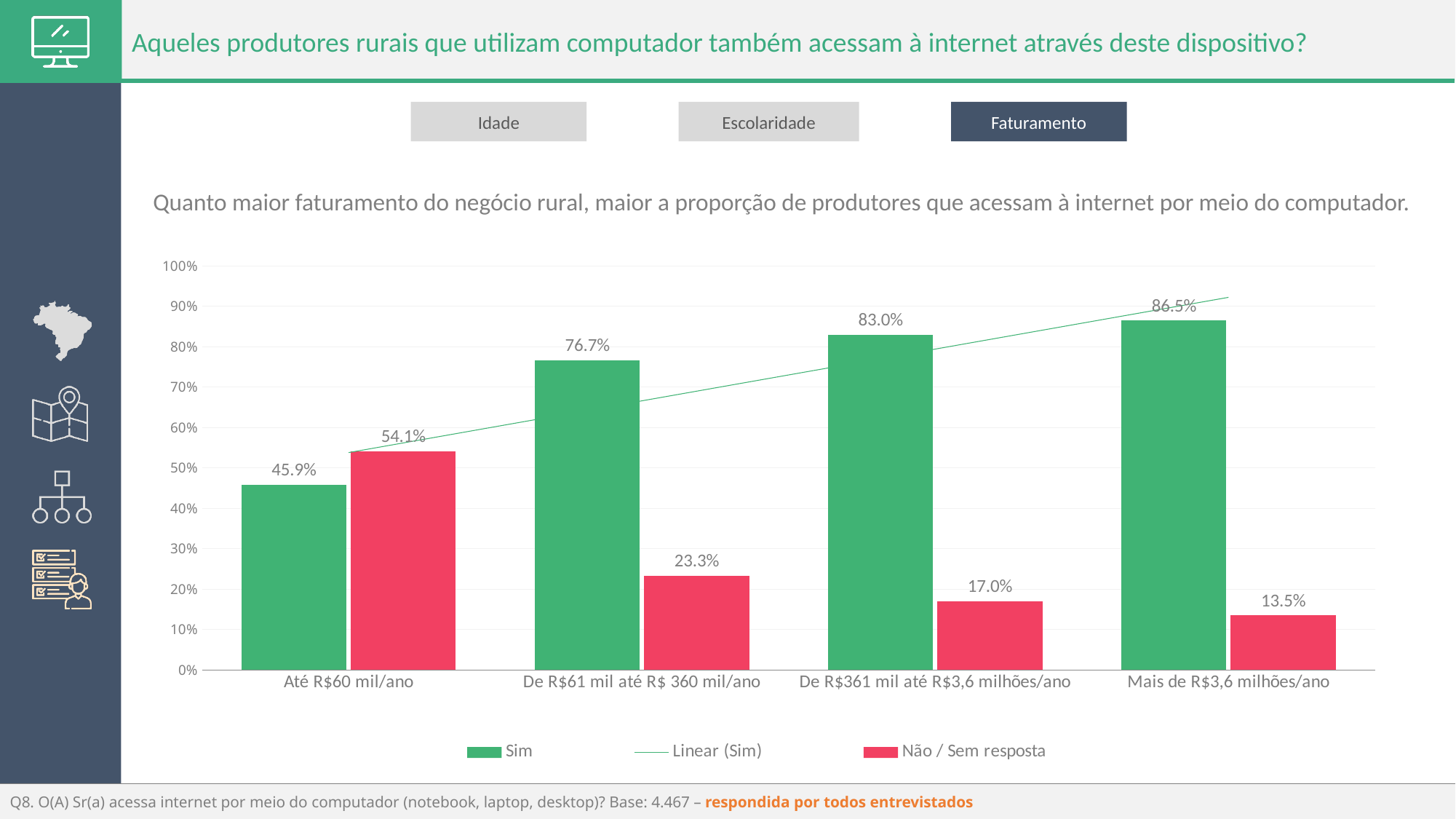
Which category has the highest "Sim" value? Mais de R$3,6 milhões/ano What is the value of "Sim" for the category "Até R$60 mil/ano"? 45.9% How many entries does the legend list? 3 Do the "Sim" values rise or fall from left to right along the x axis? rise For the category "Até R$60 mil/ano", which is larger: "Sim" or "Não / Sem resposta"? Não / Sem resposta What kind of chart is shown on the slide? bar chart How many categories are shown on the x axis? 4 What is the value of "Sim" for the category "Mais de R$3,6 milhões/ano"? 86.5% What is the difference between the "Sim" values for "De R$361 mil até R$3,6 milhões/ano" and "Até R$60 mil/ano"? 37.1% What is the value of "Não / Sem resposta" for the category "De R$61 mil até R$ 360 mil/ano"? 23.3% Is the "Sim" value for "De R$61 mil até R$ 360 mil/ano" greater or less than 70%? greater Which category has the lowest "Não / Sem resposta" value? Mais de R$3,6 milhões/ano